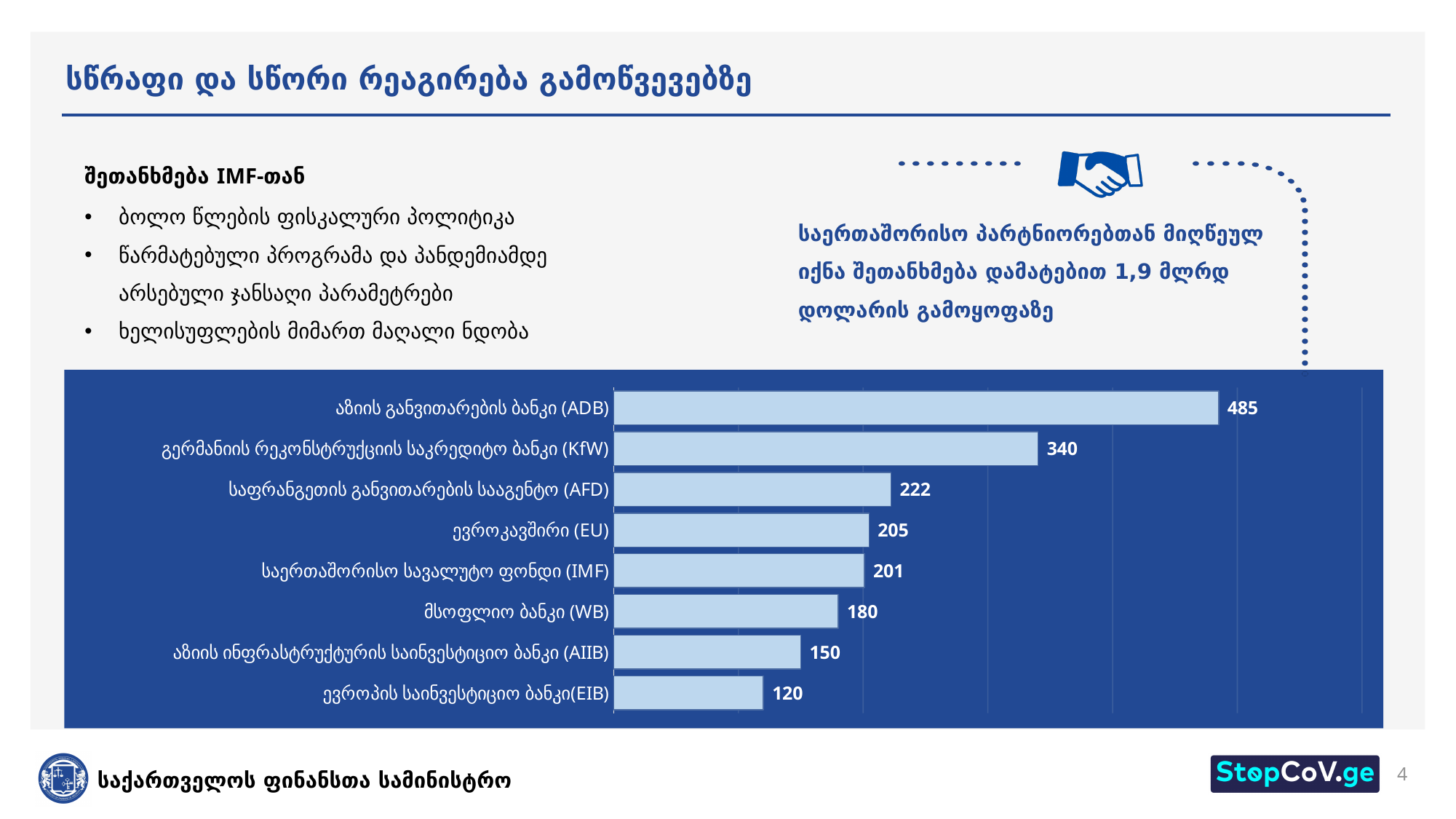
What kind of chart is shown on the slide? Bar chart What is the value shown for the European Investment Bank (EIB)? 120 What is the value shown for the World Bank (WB)? 180 Which category has the lowest value in the chart? EIB Which category has the highest value in the chart? ADB What is the difference between the values for ADB and KfW? 145 Which is larger, the value for AIIB or the value for WB? WB Do the bar values increase or decrease from the top of the chart to the bottom? Decrease What is the value for the Asian Development Bank (ADB) bar? 485 What is the difference between the values for AFD and IMF? 21 How many categories (bars) are shown in the chart? 8 What is the value shown for the European Union (EU)? 205